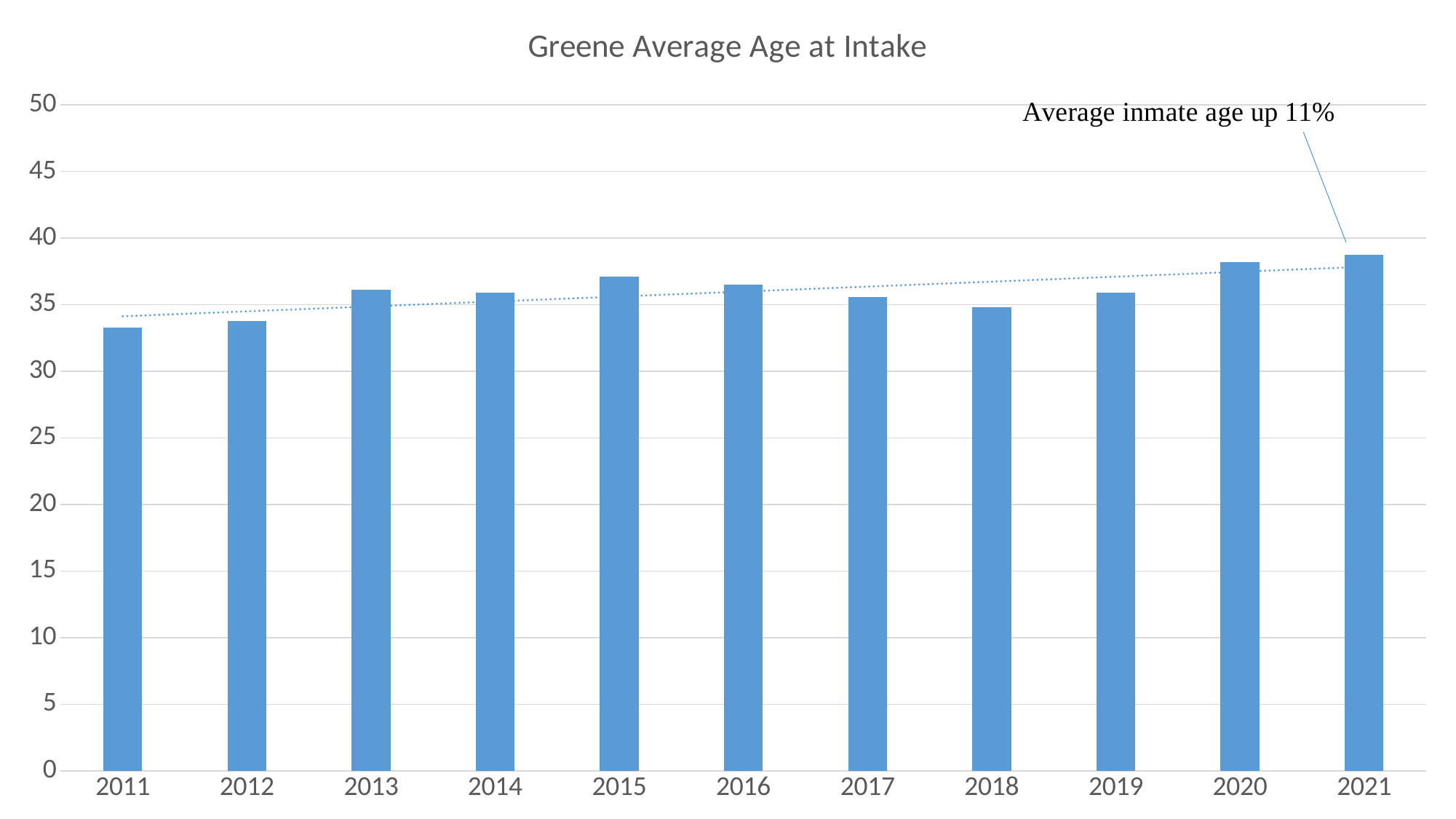
What does the annotation on the chart say about the average inmate age? Average inmate age up 11% How many years are shown on the x axis of the chart? 11 Which year has the highest average age at intake? 2021 Is the value for 2011 greater or less than 35? less Is the value for 2020 greater or less than 40? less What kind of chart is shown on the slide? bar chart Which year has the lowest average age at intake? 2011 Which year has a higher average age at intake, 2015 or 2018? 2015 Overall, do the values rise or fall from 2011 to 2021? rise What is the title of the chart? Greene Average Age at Intake Is the value for 2021 greater or less than 35? greater